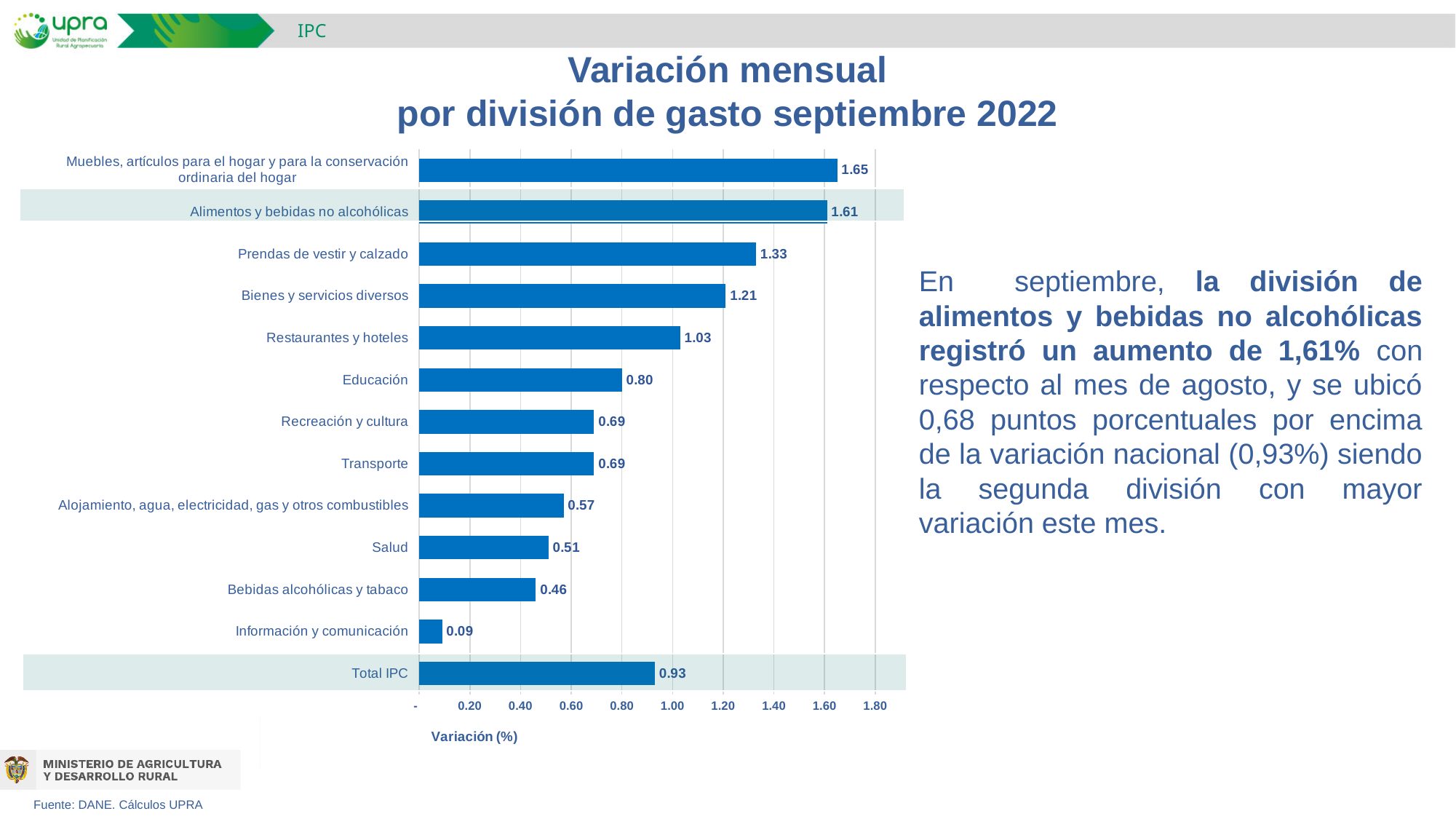
How many categories are shown in the chart? 13 What is the value for Alimentos y bebidas no alcohólicas? 1.61 Is the value for Restaurantes y hoteles greater or less than 1.00? greater What is the value for Salud? 0.51 What is the label of the horizontal axis? Variación (%) Which category has the highest value? Muebles, artículos para el hogar y para la conservación ordinaria del hogar What is the difference between the values for Alimentos y bebidas no alcohólicas and Total IPC? 0.68 Which is larger, the value for Prendas de vestir y calzado or the value for Bienes y servicios diversos? Prendas de vestir y calzado Which category has the lowest value? Información y comunicación What is the value for Total IPC? 0.93 What kind of chart is shown on the slide? Bar chart What is the difference between the values for Educación and Bebidas alcohólicas y tabaco? 0.34